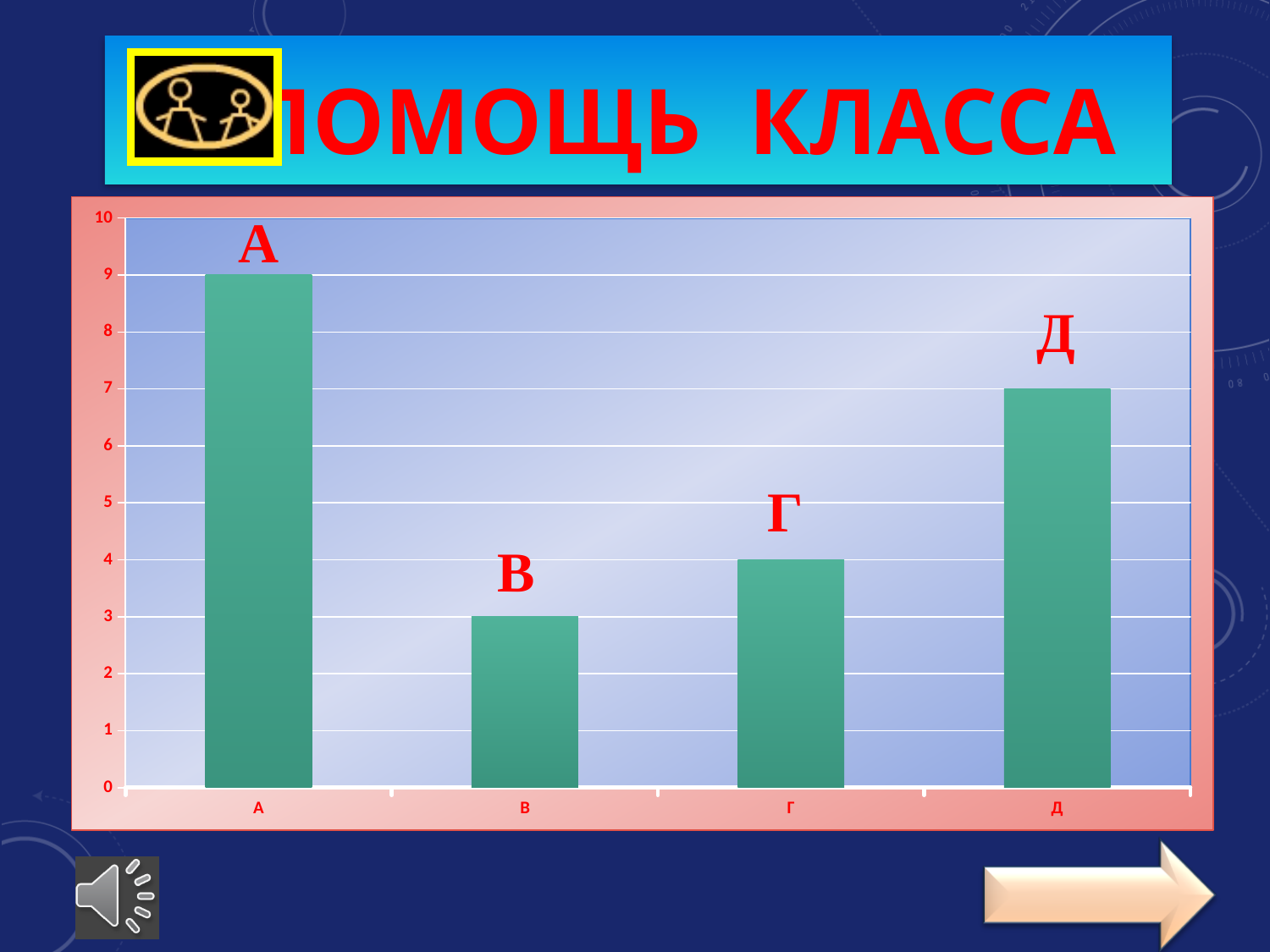
What is the maximum value shown on the vertical axis of the chart? 10 Which is larger, the value for Г or the value for В? Г What is the value of the bar for category А? 9 How many categories are shown on the x axis of the chart? 4 What is the value of the bar for category Г? 4 What is the value of the bar for category Д? 7 What is the value of the bar for category В? 3 Which category has the lowest bar? В What is the difference between the values for А and Д? 2 What type of chart is shown on the slide? bar chart Which category has the highest bar? А Is the value for Д greater or less than 5? greater